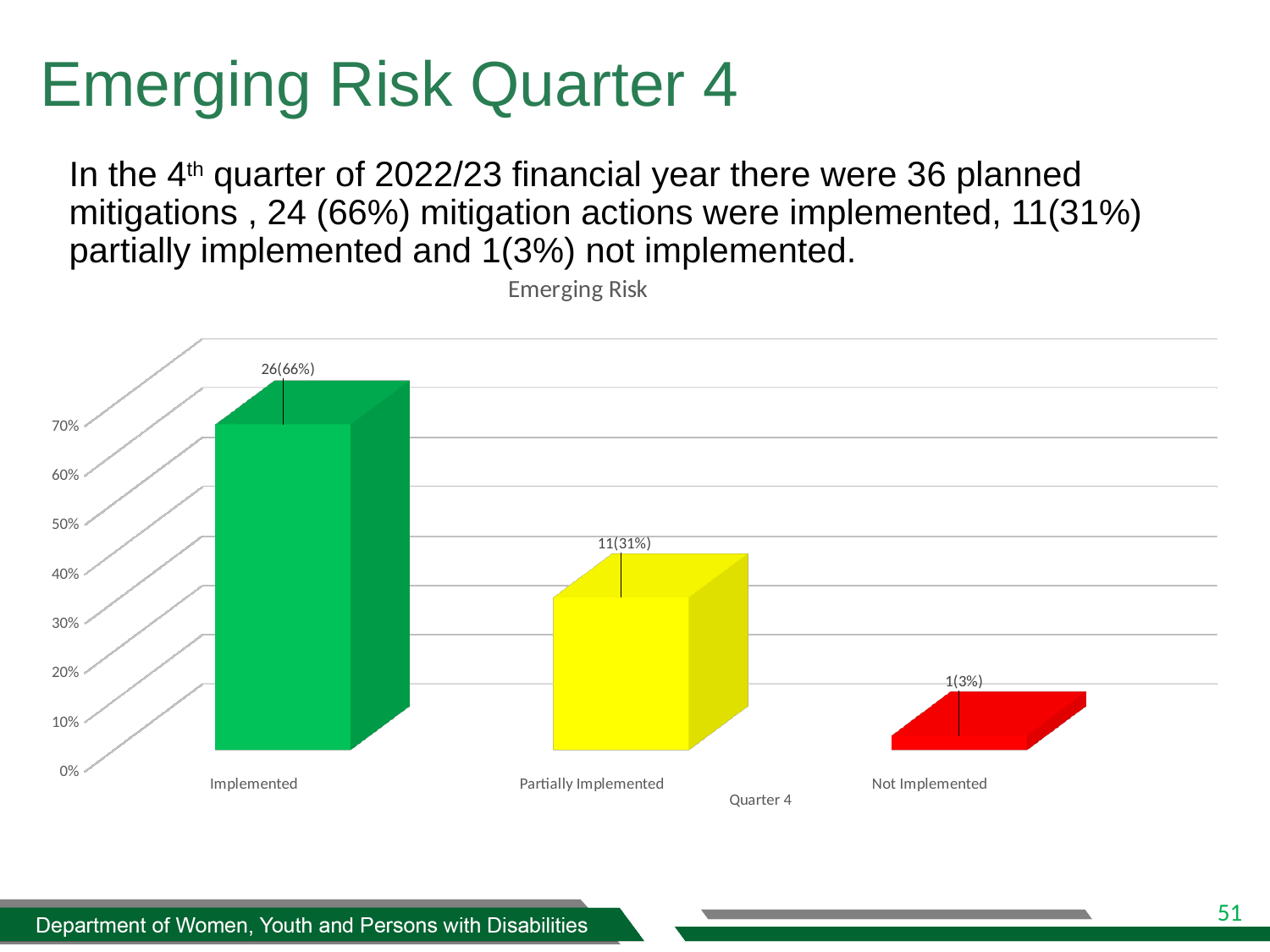
What is the data label shown for the Partially Implemented bar? 11(31%) How many categories are shown on the x axis of the chart? 3 What is the difference in percentage between Implemented (66%) and Partially Implemented (31%)? 35% What is the data label shown for the Implemented bar? 26(66%) Is the value for Partially Implemented greater or less than 40%? less Which is larger, the value for Partially Implemented or the value for Not Implemented? Partially Implemented Which category has the highest value in the chart? Implemented What type of chart is shown on the slide? Bar chart What is the title of the chart? Emerging Risk Which category has the lowest value in the chart? Not Implemented What is the data label shown for the Not Implemented bar? 1(3%) Is the value for Implemented greater or less than 60%? greater